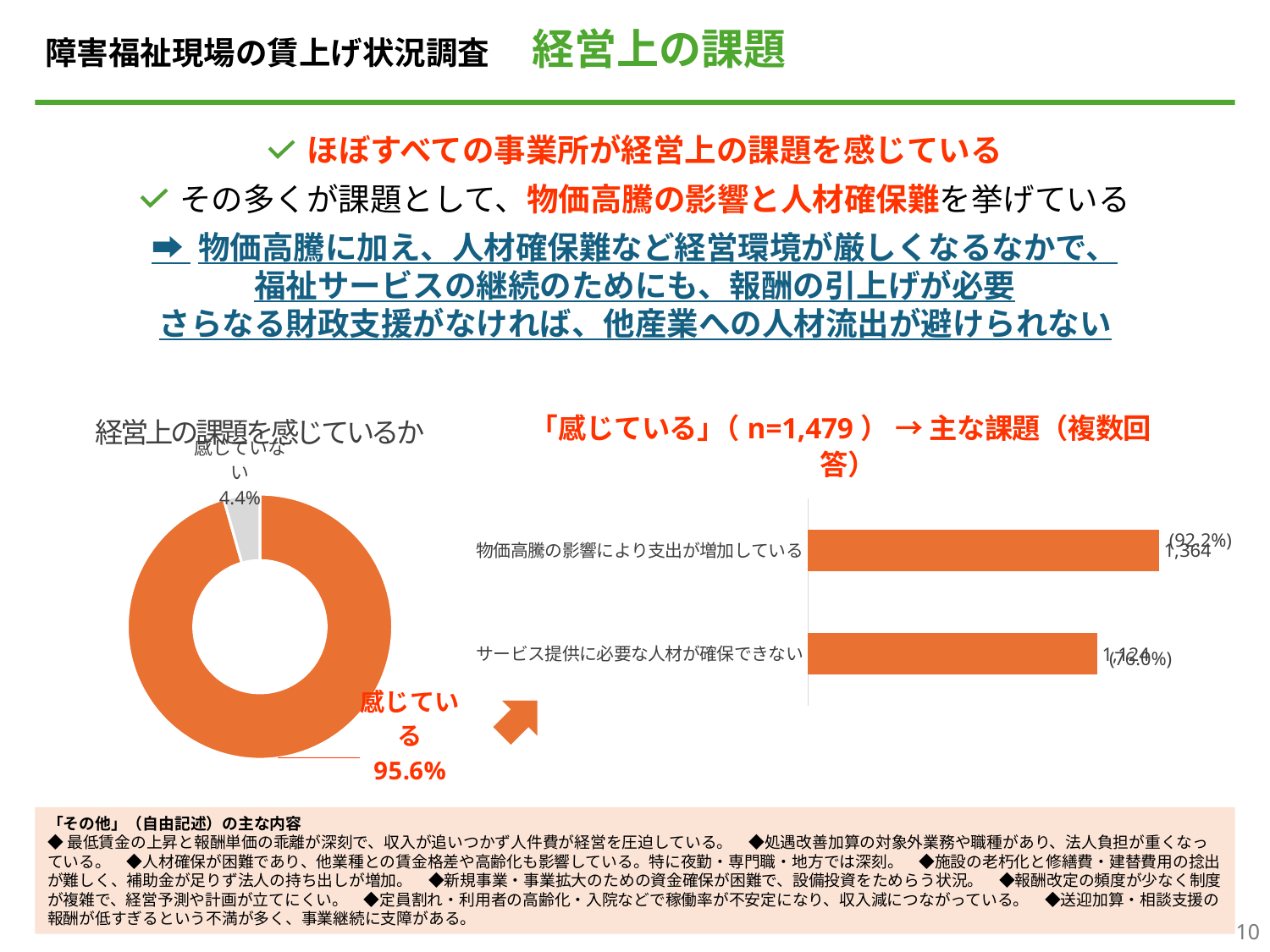
右側の「主な課題（複数回答）」の棒グラフで、「物価高騰の影響により支出が増加している」の回答数はいくつですか？ 1,364 「経営上の課題を感じているか」のドーナツグラフで、「感じている」と「感じていない」の差は何ポイントですか？ 91.2ポイント 右側の「主な課題（複数回答）」の棒グラフのタイトルに示されている回答者数（n）はいくつですか？ n=1,479 「経営上の課題を感じているか」のグラフは何種類のグラフですか？ ドーナツグラフ（円グラフ） 右側の「主な課題（複数回答）」の棒グラフで、「サービス提供に必要な人材が確保できない」の割合はいくつですか？ 76.0% 右側の「主な課題（複数回答）」の棒グラフで、回答数が最も多い項目はどれですか？ 物価高騰の影響により支出が増加している 「経営上の課題を感じているか」のドーナツグラフで、「感じている」の割合はいくつですか？ 95.6% 右側の「主な課題（複数回答）」の棒グラフで、「物価高騰の影響により支出が増加している」と「サービス提供に必要な人材が確保できない」の回答数の差はいくつですか？ 240 「経営上の課題を感じているか」のドーナツグラフで、最も大きい区分はどれですか？ 感じている 「経営上の課題を感じているか」のドーナツグラフで、「感じていない」の割合はいくつですか？ 4.4% 「経営上の課題を感じているか」のドーナツグラフには、いくつの区分がありますか？ 2 右側の「主な課題（複数回答）」の棒グラフで、「サービス提供に必要な人材が確保できない」の回答数はいくつですか？ 1,124